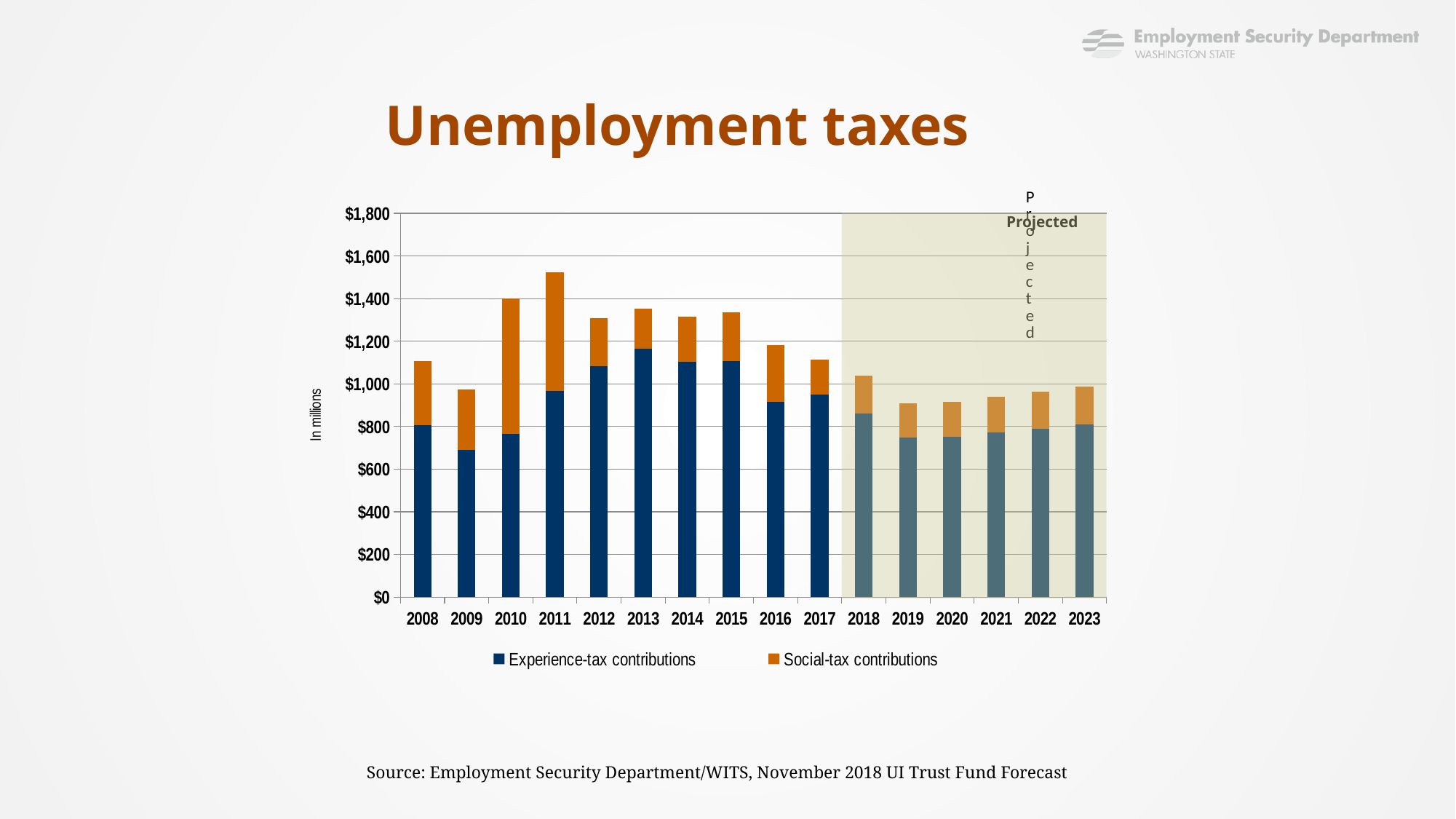
Is the total for 2011 greater or less than $1,400? greater Is the total for 2019 greater or less than $1,000? less Are the Experience-tax contributions for 2013 greater or less than $1,000? greater What kind of chart is shown on the slide? Stacked bar chart Do the total contributions rise or fall from 2019 to 2023? rise Which year has the highest total unemployment tax contributions? 2011 How many years are shown on the x axis? 16 How many series does the legend list? 2 Which year has the lowest Experience-tax contributions? 2009 What label is shown on the shaded region covering 2018 to 2023? Projected Which year has a larger total, 2010 or 2012? 2010 Which year has the highest Experience-tax contributions? 2013